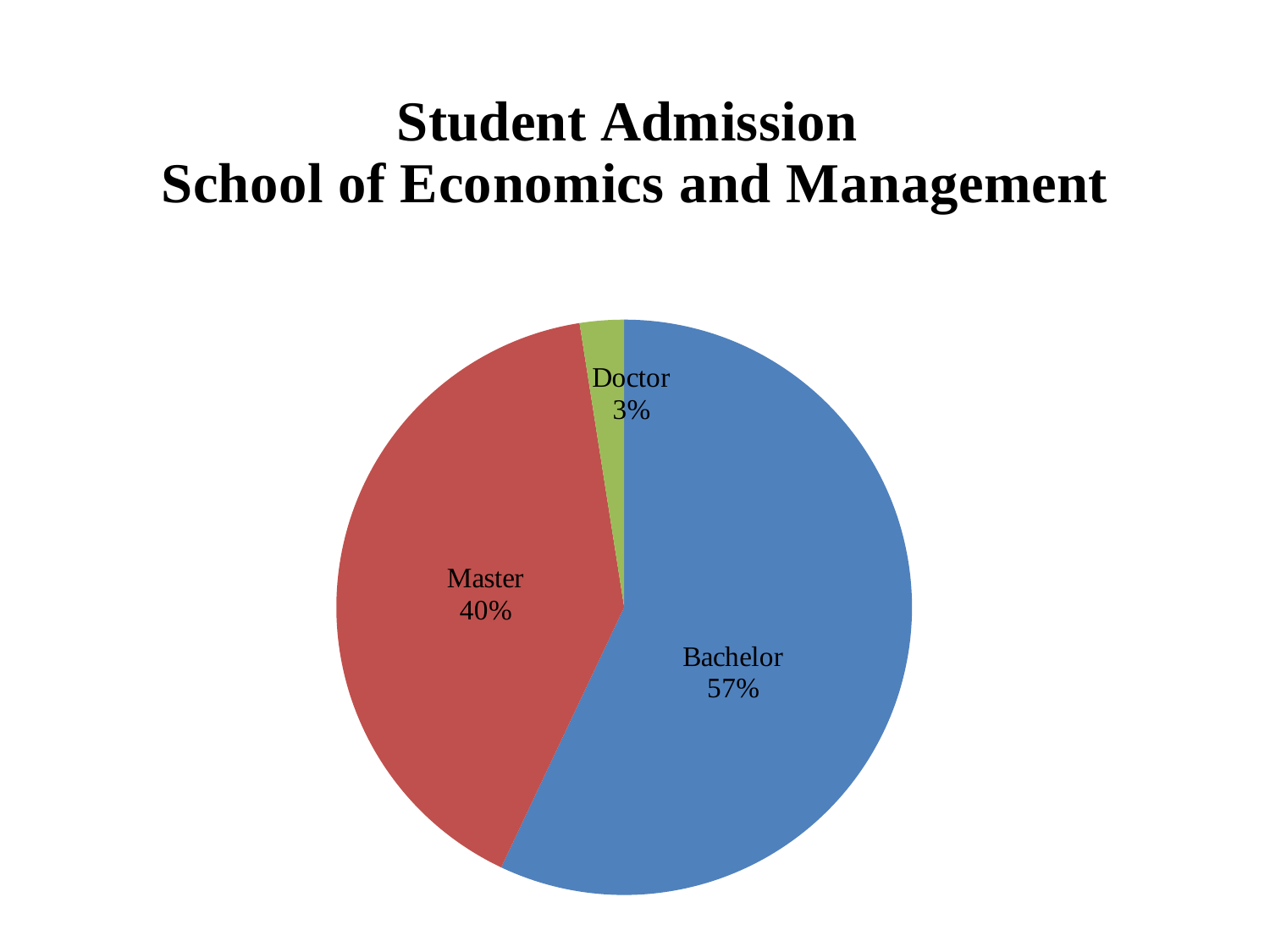
Which category has the smallest share of the pie? Doctor What kind of chart is shown on the slide? Pie chart What is the difference in percentage points between the Bachelor and Master shares? 17 What colour is the Bachelor slice? Blue What is the difference in percentage points between the Master and Doctor shares? 37 What is the title of the slide? Student Admission School of Economics and Management What share of student admissions is Master? 40% How many categories are shown in the pie chart? 3 Which is larger, the Master share or the Doctor share? Master What share of student admissions is Bachelor? 57% What share of student admissions is Doctor? 3% Which category has the largest share of the pie? Bachelor